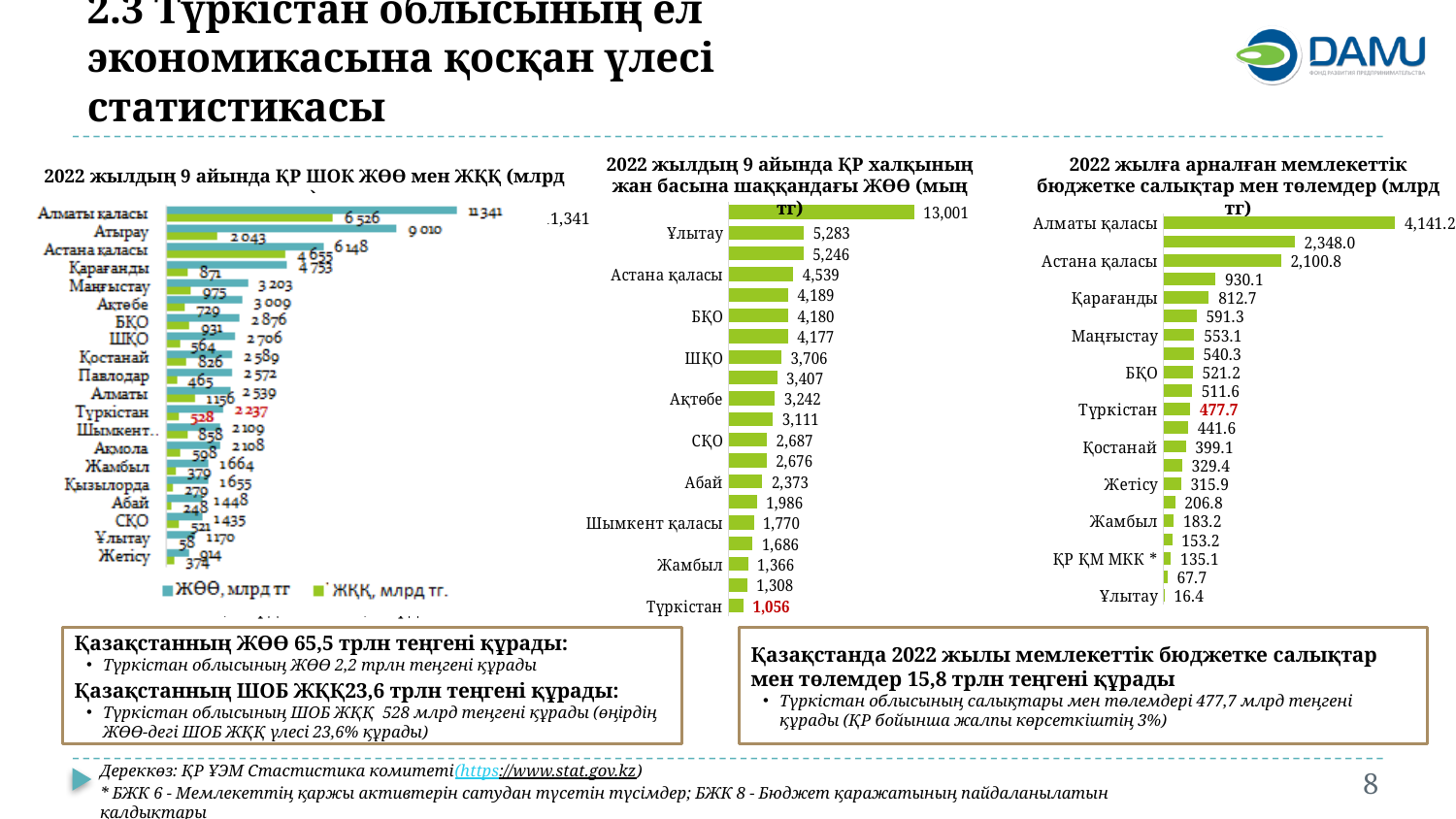
In the chart titled '2022 жылға арналған мемлекеттік бюджетке салықтар мен төлемдер (млрд тг)', what is the difference between Алматы қаласы and Астана қаласы? 2,040.4 In the middle chart titled '2022 жылдың 9 айында ҚР халқының жан басына шаққандағы ЖӨӨ (мың тг)', what is the value for Астана қаласы? 4,539 In the chart titled '2022 жылға арналған мемлекеттік бюджетке салықтар мен төлемдер (млрд тг)', which region has the lowest value? Ұлытау How many series does the legend of the left chart titled '2022 жылдың 9 айында ҚР ШОК ЖӨӨ мен ЖҚҚ (млрд тг)' list? 2 In the middle chart titled '2022 жылдың 9 айында ҚР халқының жан басына шаққандағы ЖӨӨ (мың тг)', which region has the lowest value? Түркістан In the chart titled '2022 жылға арналған мемлекеттік бюджетке салықтар мен төлемдер (млрд тг)', how many bars are plotted? 21 In the middle chart titled '2022 жылдың 9 айында ҚР халқының жан басына шаққандағы ЖӨӨ (мың тг)', what is the value for Түркістан? 1,056 In the chart titled '2022 жылға арналған мемлекеттік бюджетке салықтар мен төлемдер (млрд тг)', which region has the highest value? Алматы қаласы In the chart titled '2022 жылға арналған мемлекеттік бюджетке салықтар мен төлемдер (млрд тг)', what is the value for Түркістан? 477.7 In the chart titled '2022 жылға арналған мемлекеттік бюджетке салықтар мен төлемдер (млрд тг)', what is the value for Жамбыл? 183.2 In the middle chart titled '2022 жылдың 9 айында ҚР халқының жан басына шаққандағы ЖӨӨ (мың тг)', which is larger, ШҚО or Ақтөбе? ШҚО What kind of chart is the left chart titled '2022 жылдың 9 айында ҚР ШОК ЖӨӨ мен ЖҚҚ (млрд тг)'? Bar chart